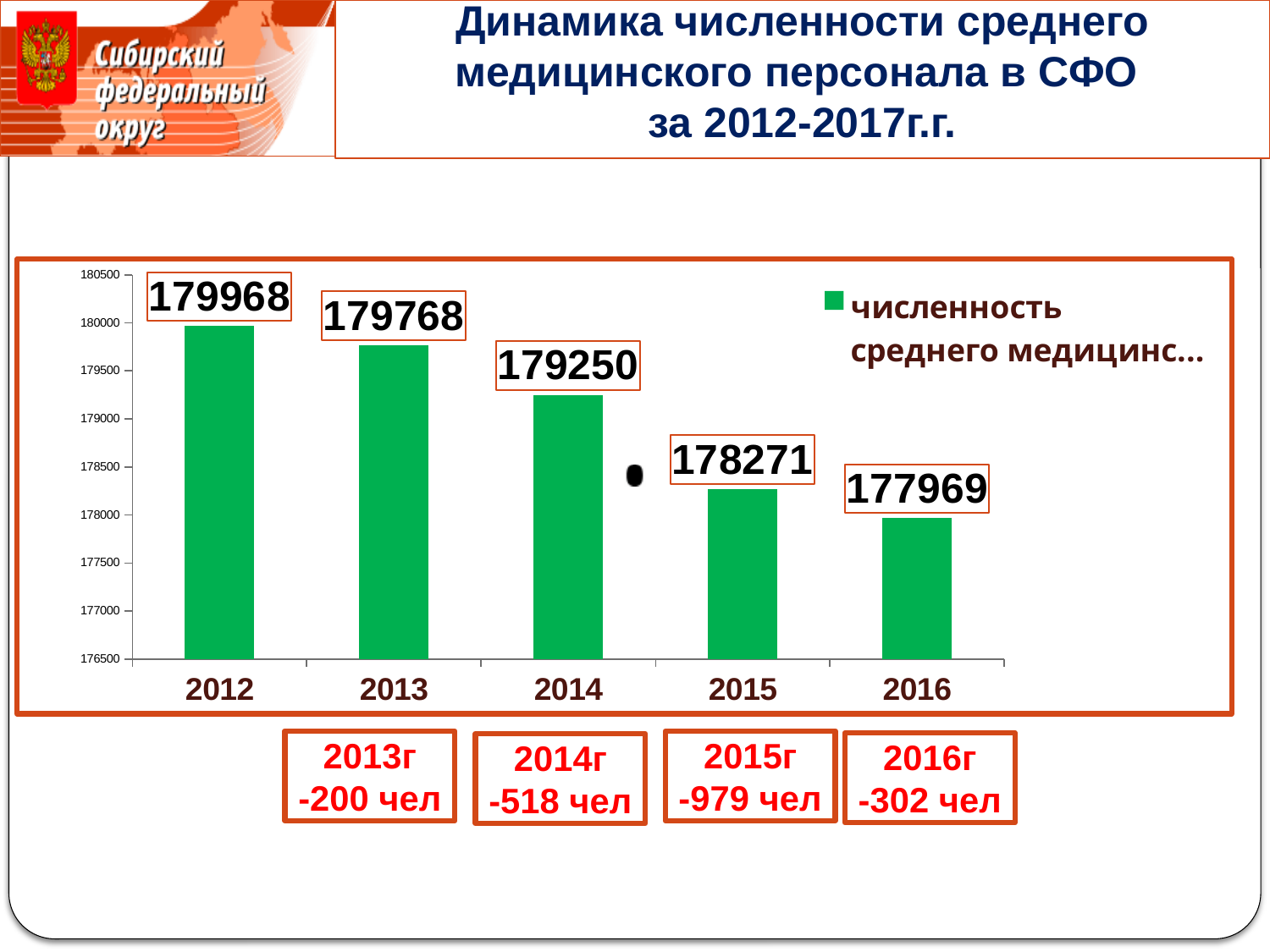
What is the value for 2012? 179968 Which year has the highest value? 2012 What kind of chart is this? bar chart What is the value for 2014? 179250 Which year has the lowest value? 2016 What is the value for 2016? 177969 What is the difference between the values for 2012 and 2013? 200 Which is larger, the value for 2013 or the value for 2015? 2013 Do the values rise or fall from 2012 to 2016? fall How many years are shown on the x axis? 5 Is the value for 2015 greater or less than 178500? less What is the difference between the values for 2014 and 2015? 979